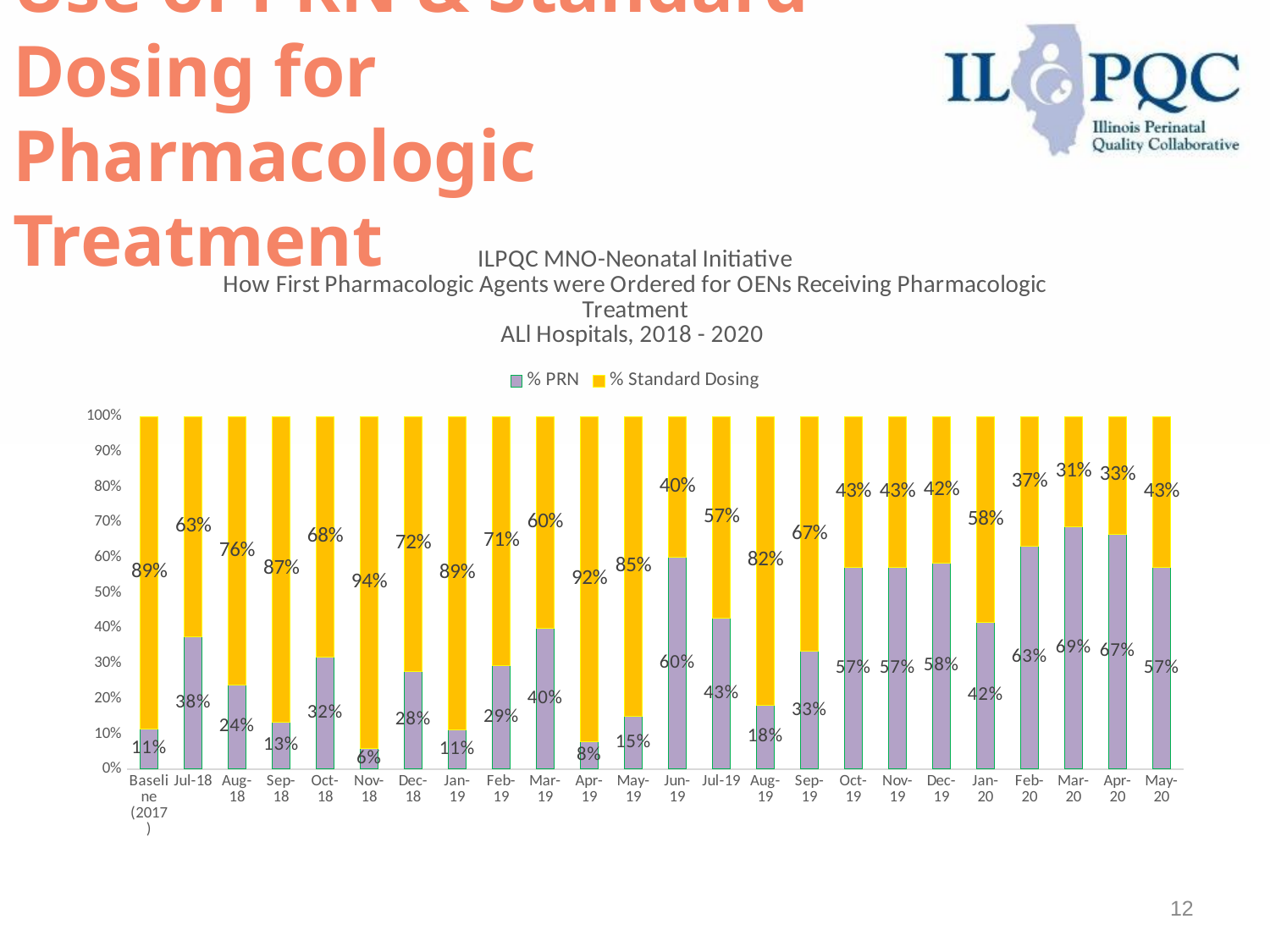
Which month has the highest % Standard Dosing value? Nov-18 What type of chart is shown on the slide? Stacked bar chart How many series does the legend list? 2 Which colour represents % Standard Dosing in the chart? Yellow What is the % Standard Dosing value for Jun-19? 40% What is the difference between the % PRN values for Jun-19 and Jul-19? 17% What is the % PRN value for the Baseline (2017) bar? 11% How many time periods (bars) are shown on the x axis? 24 Is the % PRN value higher in Feb-20 or in Jan-20? Feb-20 Which month has the highest % PRN value? Mar-20 What is the % PRN value for Nov-18? 6% Which month has the lowest % Standard Dosing value? Mar-20